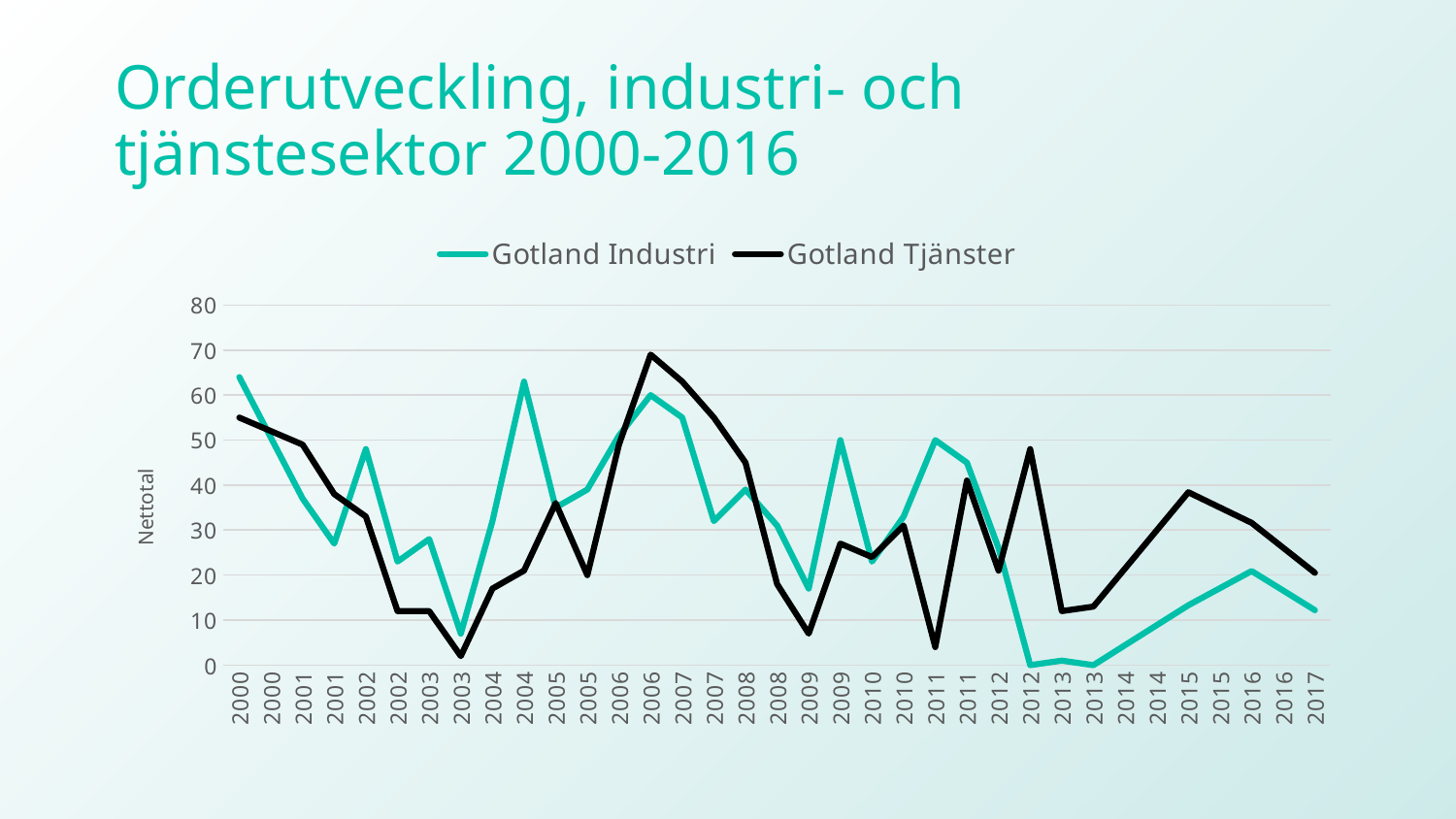
How many series does the legend list? 2 Is the second 2012 value for Gotland Industri greater or less than 10? less At 2017, which series has the higher value, Gotland Industri or Gotland Tjänster? Gotland Tjänster What is the label on the vertical axis? Nettotal At the first 2000 point, which series has the higher value, Gotland Industri or Gotland Tjänster? Gotland Industri Is the 2017 value for Gotland Tjänster greater or less than 30? less Is the first 2000 value for Gotland Industri greater or less than 60? greater What kind of chart is shown on the slide? line chart Does the Gotland Industri line overall rise or fall from 2000 to 2017? fall What is the title of the chart on the slide? Orderutveckling, industri- och tjänstesektor 2000-2016